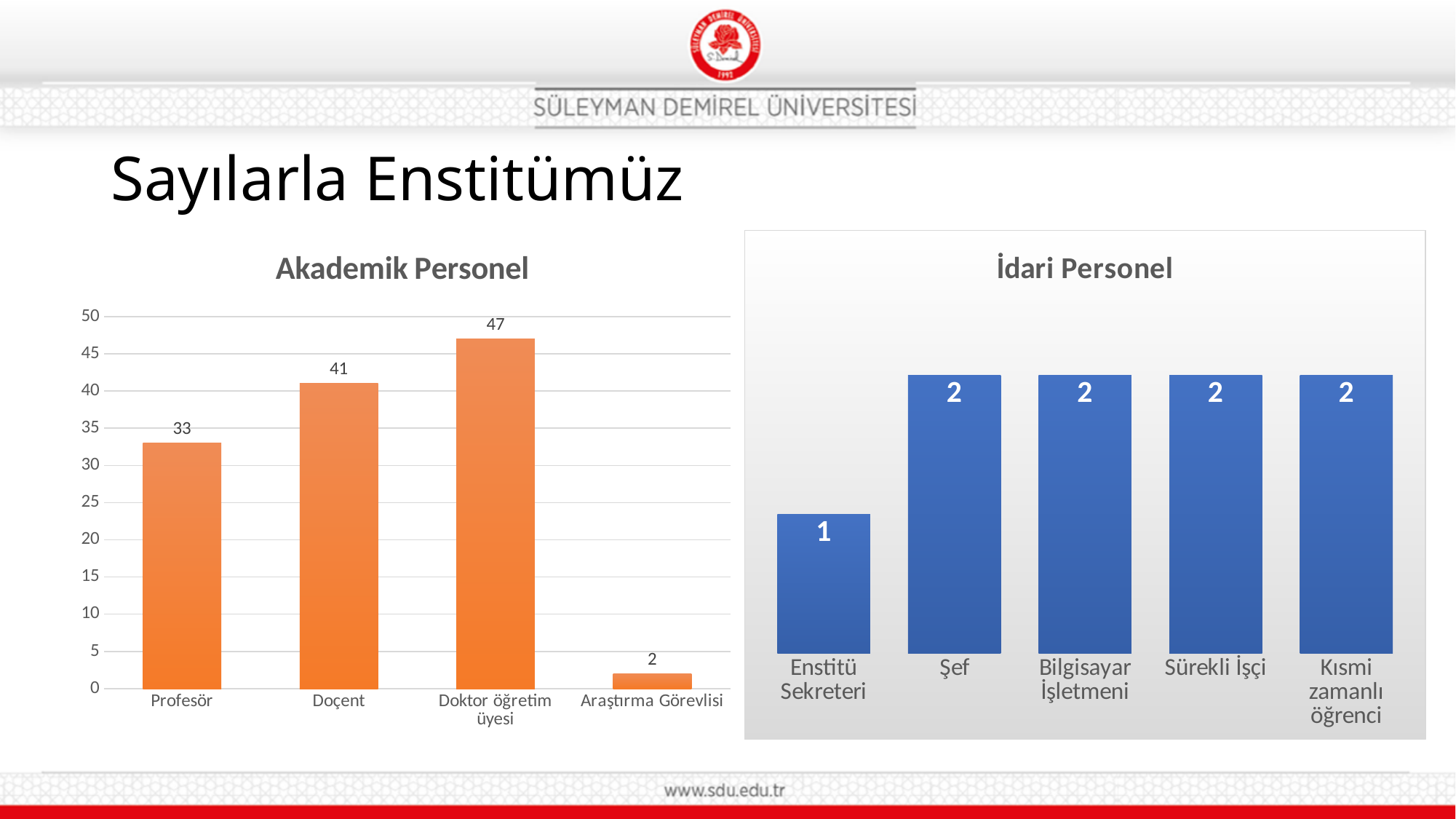
In the Akademik Personel chart, which is larger, the value for Profesör or the value for Doçent? Doçent What kind of chart is the İdari Personel chart? Bar chart In the İdari Personel chart, how many categories are shown? 5 In the İdari Personel chart, which category has the lowest value? Enstitü Sekreteri In the İdari Personel chart, what is the value for Enstitü Sekreteri? 1 In the İdari Personel chart, what is the value for Sürekli İşçi? 2 In the Akademik Personel chart, how many categories are shown? 4 In the Akademik Personel chart, which category has the lowest value? Araştırma Görevlisi In the Akademik Personel chart, what is the value for Araştırma Görevlisi? 2 In the Akademik Personel chart, what is the value for Doçent? 41 In the Akademik Personel chart, what is the difference between the values for Doktor öğretim üyesi and Profesör? 14 In the Akademik Personel chart, which category has the highest value? Doktor öğretim üyesi